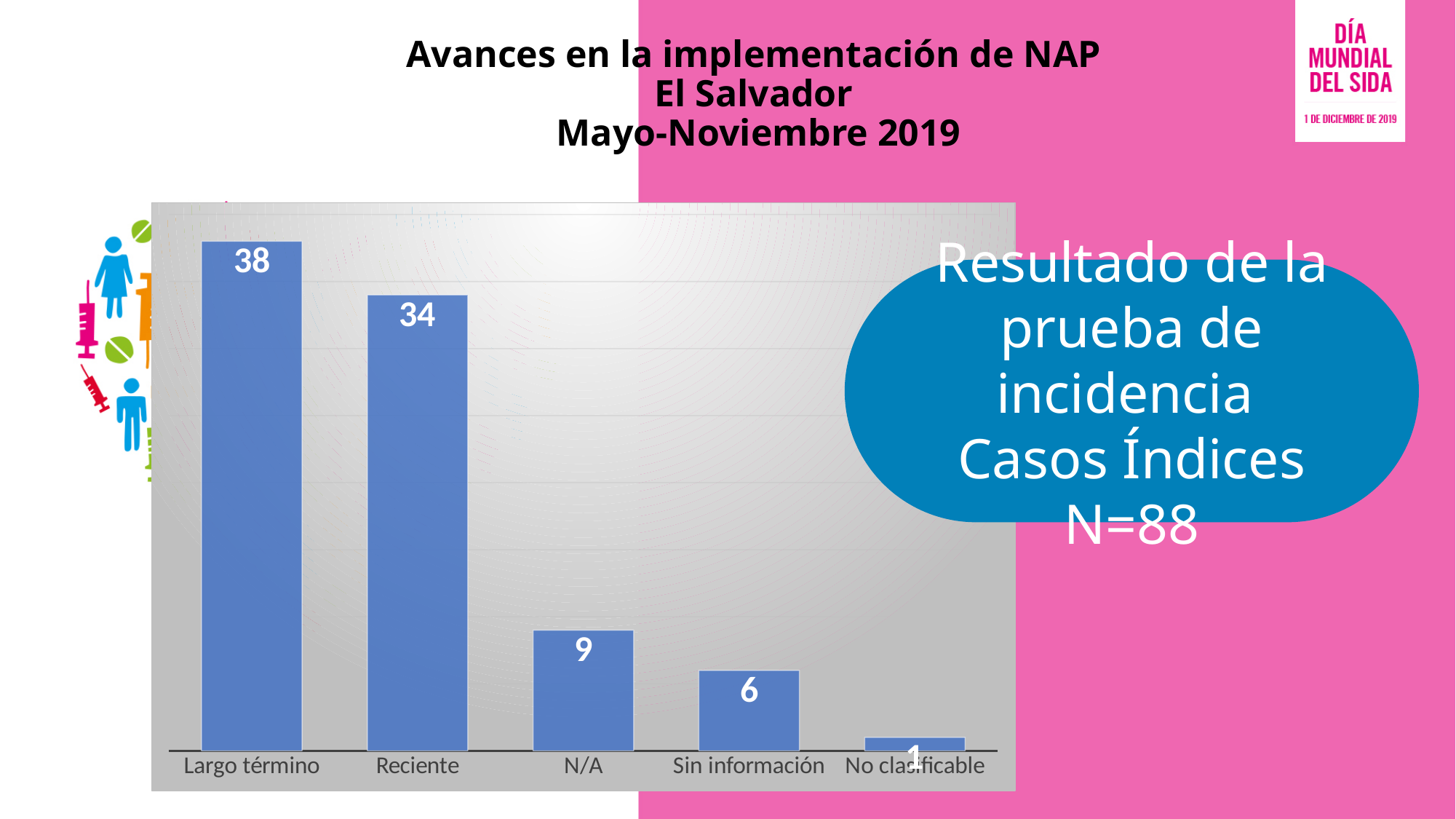
How many categories are shown in the chart? 5 Which category has the lowest value? No clasificable What is the value for N/A? 9 What is the difference between the values for N/A and Sin información? 3 What is the value for Sin información? 6 What is the value for Largo término? 38 Which category has the highest value? Largo término What kind of chart is shown on the slide? Bar chart What is the value for Reciente? 34 Which is larger, the value for Reciente or the value for N/A? Reciente What is the difference between the values for Largo término and Reciente? 4 Do the values rise or fall from left to right across the categories? Fall